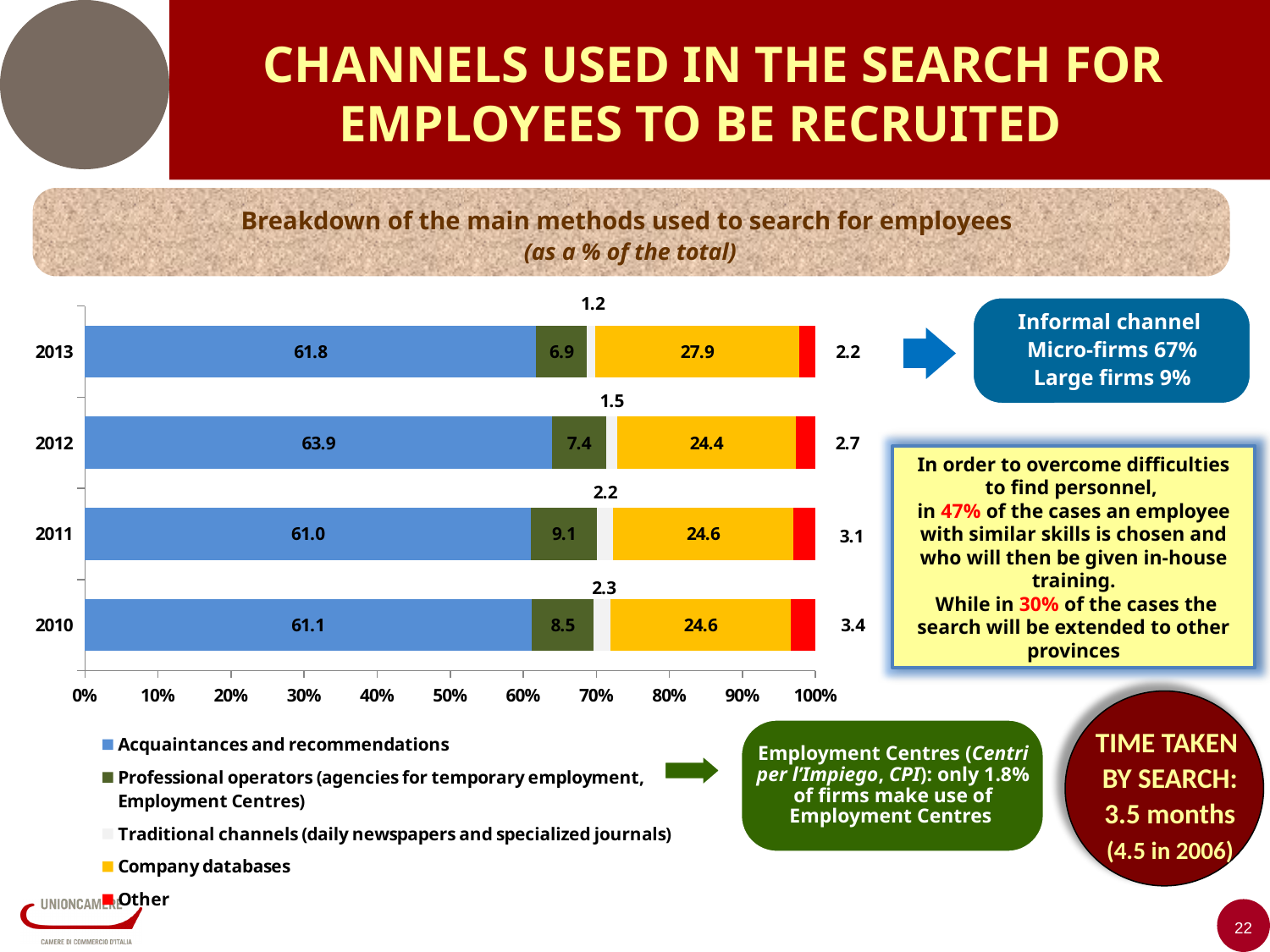
Does the value for Other rise or fall from 2010 to 2013? Fall Which year has the larger value for Professional operators (agencies for temporary employment, Employment Centres), 2011 or 2010? 2011 What is the value for Acquaintances and recommendations in 2013? 61.8 What kind of chart is shown on the slide? Stacked bar chart What is the value for Other in 2010? 3.4 What is the difference between the Company databases values for 2013 and 2012? 3.5 What is the value for Traditional channels (daily newspapers and specialized journals) in 2011? 2.2 In which year is the value for Acquaintances and recommendations highest? 2012 In which year is the value for Professional operators (agencies for temporary employment, Employment Centres) lowest? 2013 How many years are shown in the chart? 4 What is the value for Company databases in 2012? 24.4 How many series does the legend list? 5